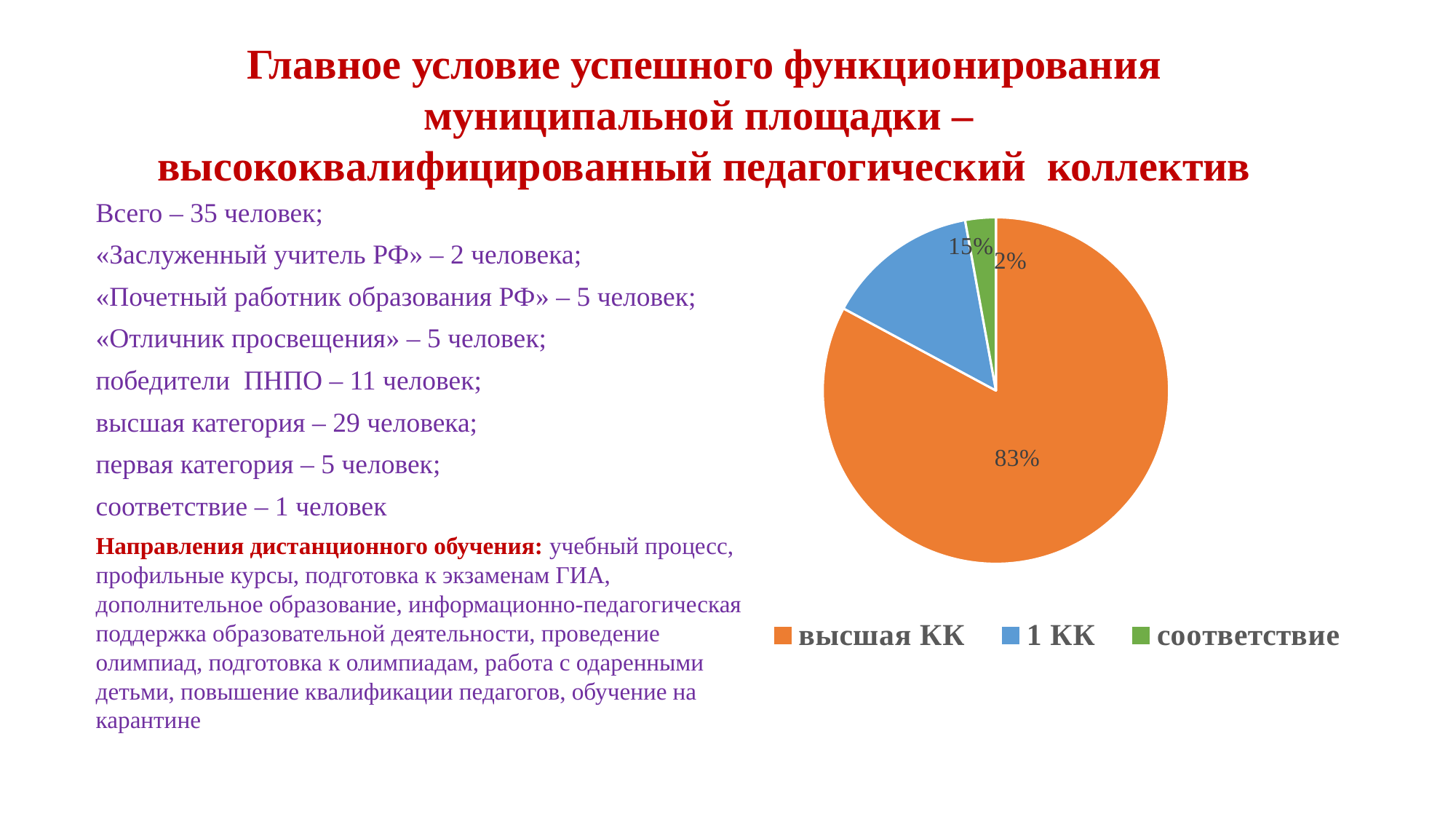
What type of chart is shown on the slide? pie chart What colour is the slice for "соответствие"? green What is the difference in percentage points between "1 КК" and "соответствие"? 13 What is the difference in percentage points between "высшая КК" and "1 КК"? 68 How many categories does the pie chart have? 3 What share of the pie does "соответствие" have? 2% Which category has the smallest slice of the pie? соответствие Which category has the largest slice of the pie? высшая КК What colour is the slice for "1 КК"? blue Which is larger, the slice for "1 КК" or the slice for "соответствие"? 1 КК What share of the pie does "высшая КК" have? 83% What share of the pie does "1 КК" have? 15%